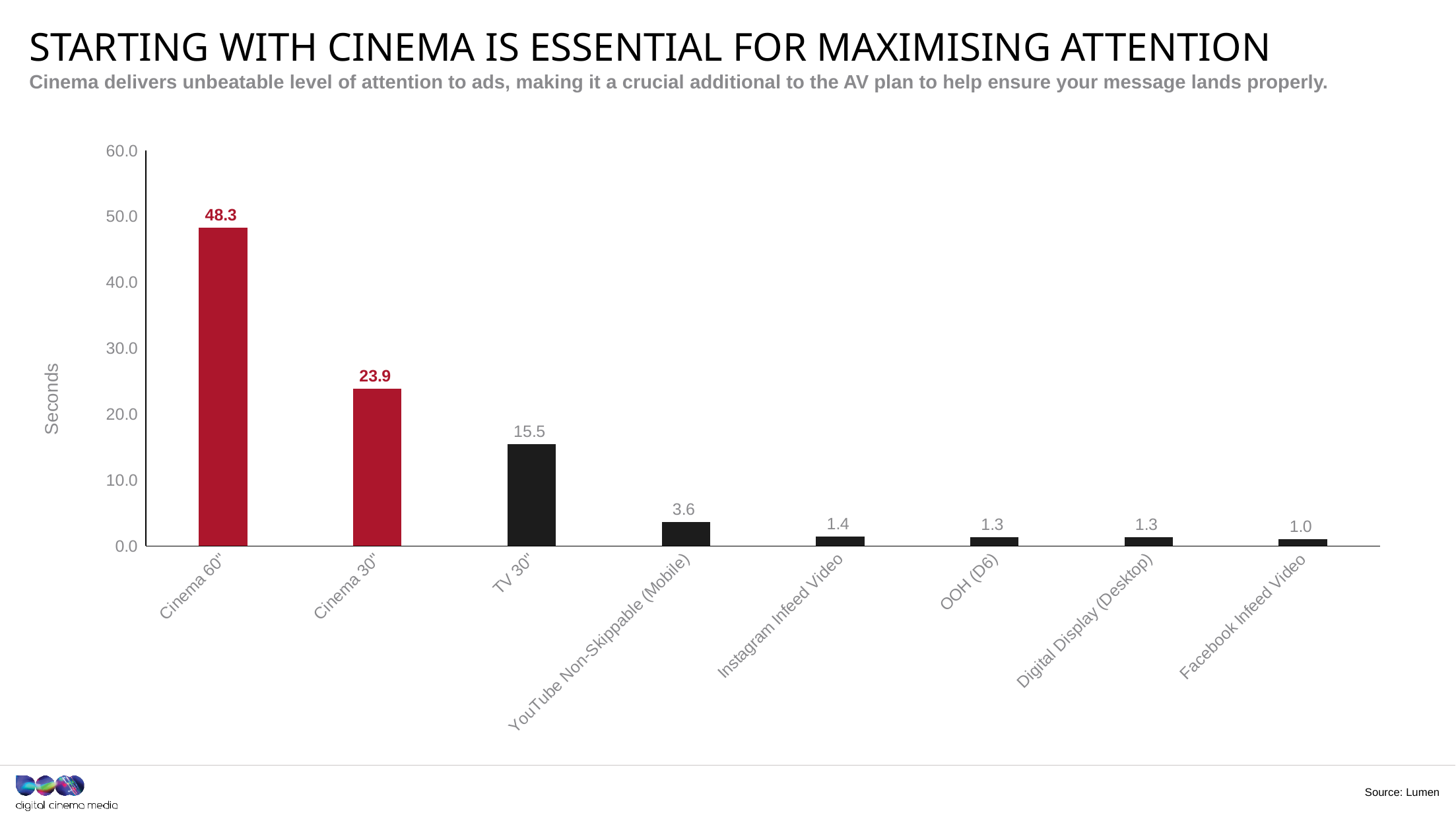
How many categories are shown on the chart? 8 What is the value for TV 30"? 15.5 What kind of chart is shown on the slide? Bar chart Which category has the highest value? Cinema 60" Which category has the lowest value? Facebook Infeed Video What is the difference between the values for Cinema 30" and TV 30"? 8.4 Which is larger, the value for TV 30" or the value for YouTube Non-Skippable (Mobile)? TV 30" What is the value for Facebook Infeed Video? 1.0 What is the label of the vertical axis? Seconds What is the value for YouTube Non-Skippable (Mobile)? 3.6 What is the difference between the values for Cinema 60" and Cinema 30"? 24.4 What is the value for Cinema 60"? 48.3